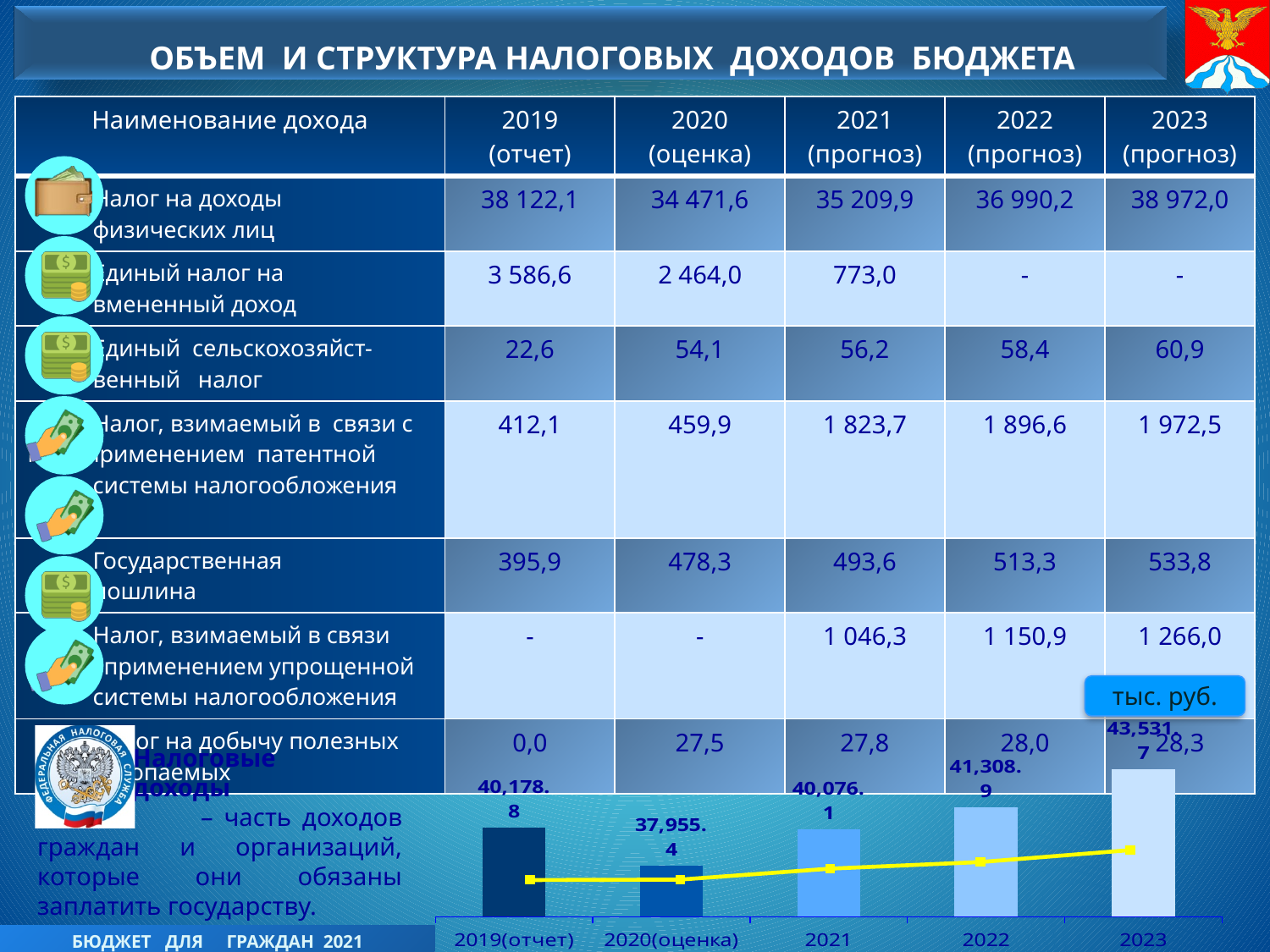
In the bar chart at the bottom of the slide, what is the difference between the 2022 value and the 2021 value? 1,232.8 In the bar chart at the bottom of the slide, which year has the lowest value? 2020(оценка) In the bar chart at the bottom of the slide, which year has the highest value? 2023 In the bar chart at the bottom of the slide, what is the value for 2020(оценка)? 37,955.4 In the bar chart at the bottom of the slide, what is the difference between the 2023 value and the 2019(отчет) value? 3,352.9 In the bar chart at the bottom of the slide, do the values rise or fall from 2020(оценка) to 2023? rise In the bar chart at the bottom of the slide, what is the value for 2022? 41,308.9 In the bar chart at the bottom of the slide, what is the value for 2023? 43,531.7 In the bar chart at the bottom of the slide, what is the value for 2019(отчет)? 40,178.8 In the bar chart at the bottom of the slide, what is the value for 2021? 40,076.1 How many categories (years) are shown on the x axis of the bar chart at the bottom of the slide? 5 In the bar chart at the bottom of the slide, which is larger: the value for 2019(отчет) or the value for 2021? 2019(отчет)